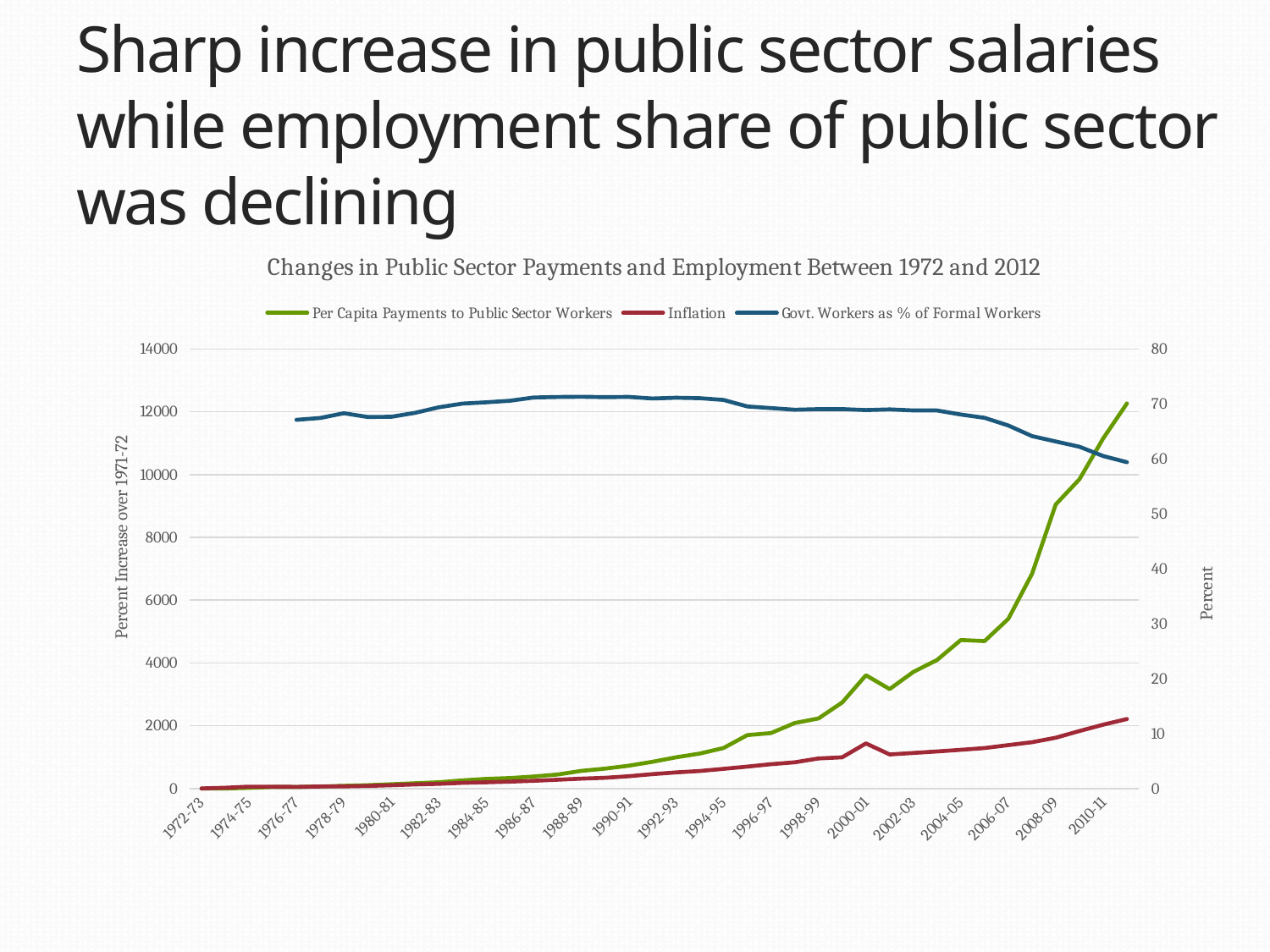
At 2008-09, which is larger: Per Capita Payments to Public Sector Workers or Inflation? Per Capita Payments to Public Sector Workers What is the label on the left vertical axis? Percent Increase over 1971-72 Is the value for Govt. Workers as % of Formal Workers at 2010-11 greater or less than 70? less How many series does the legend list? 3 Is the value for Inflation at 2010-11 greater or less than 1000? greater Does the Per Capita Payments to Public Sector Workers line rise or fall from 1972-73 to 2010-11? Rise What kind of chart is shown on the slide? Line chart What is the title of the chart? Changes in Public Sector Payments and Employment Between 1972 and 2012 How many year labels are shown on the x axis? 20 Is the value for Govt. Workers as % of Formal Workers at 1988-89 greater or less than 60? greater Does the Govt. Workers as % of Formal Workers line rise or fall overall from 1972-73 to 2010-11? Fall